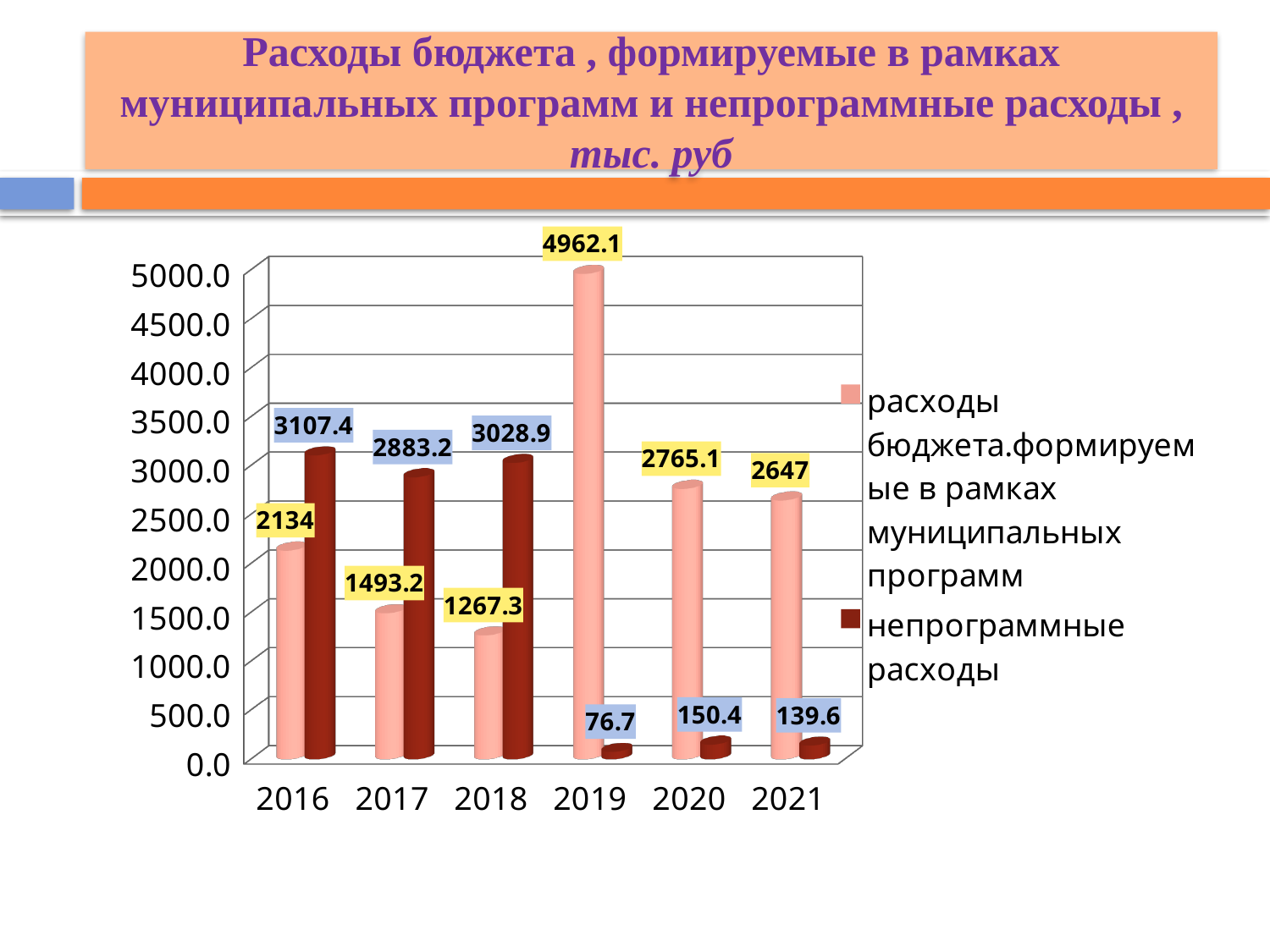
In which year is расходы бюджета, формируемые в рамках муниципальных программ the highest? 2019 How many years are shown on the x axis? 6 What is the value of расходы бюджета, формируемые в рамках муниципальных программ for 2018? 1267.3 What is the value of расходы бюджета, формируемые в рамках муниципальных программ for 2019? 4962.1 What is the value of непрограммные расходы for 2021? 139.6 What is the value of непрограммные расходы for 2016? 3107.4 What kind of chart is shown on the slide? bar chart What is the difference between the two series in 2016? 973.4 Is the value of расходы бюджета, формируемые в рамках муниципальных программ for 2020 greater or less than 2500.0? greater How many series does the legend list? 2 In which year is непрограммные расходы the lowest? 2019 Which series has the larger value in 2017? непрограммные расходы